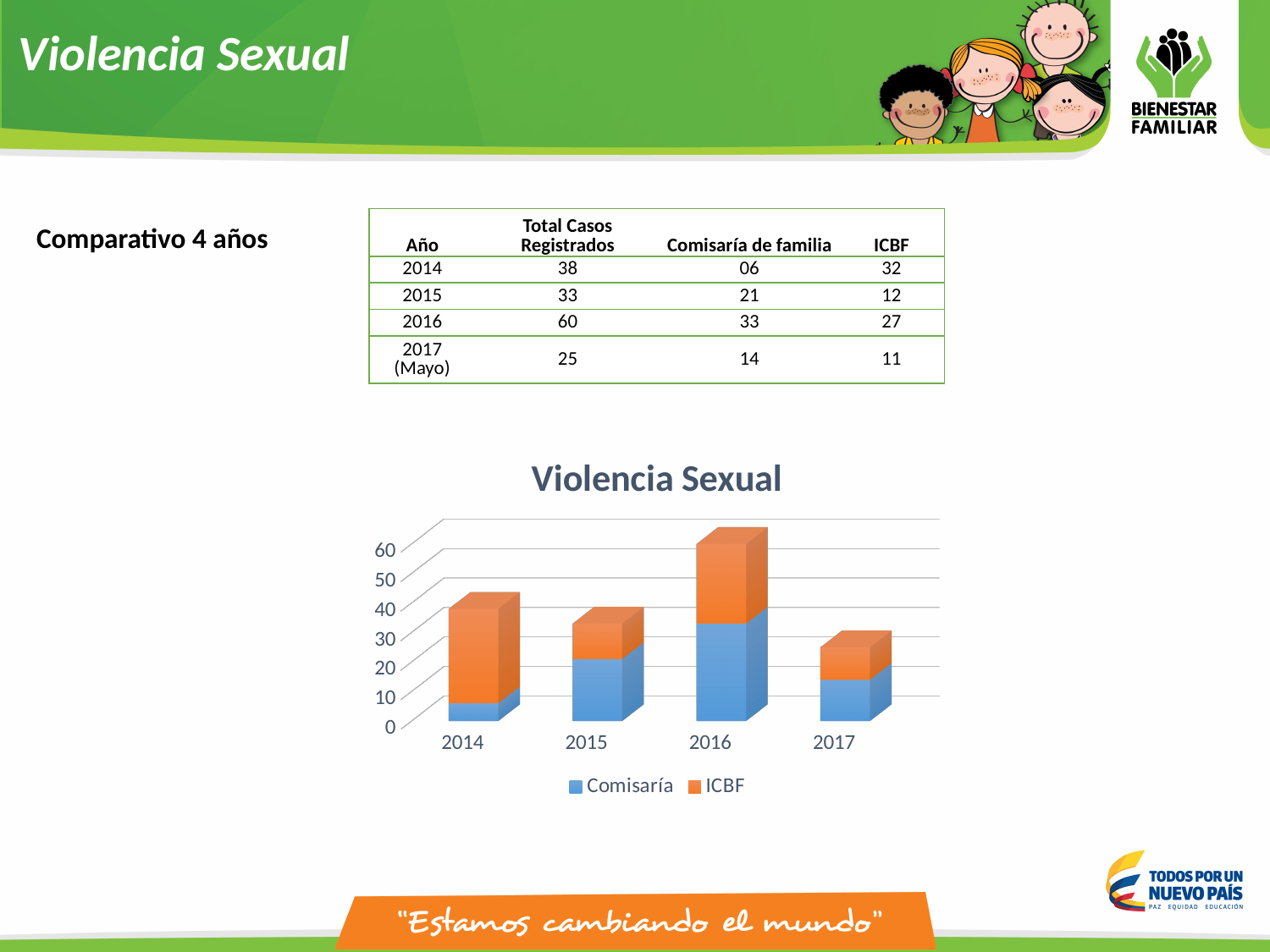
Is the total stacked bar for 2017 greater or less than 30? less What is the Comisaría value for 2015? 21 What is the difference between the Comisaría value and the ICBF value in 2016? 6 Which year has the shortest stacked bar in the chart? 2017 What is the title of the chart? Violencia Sexual What type of chart is shown on the slide? bar chart What is the total of the stacked bar for 2016? 60 How many years are shown on the x axis of the chart? 4 How many series does the chart legend list? 2 Which is larger in 2014, the Comisaría segment or the ICBF segment? ICBF Which year has the tallest stacked bar in the chart? 2016 What is the ICBF value for 2014? 32